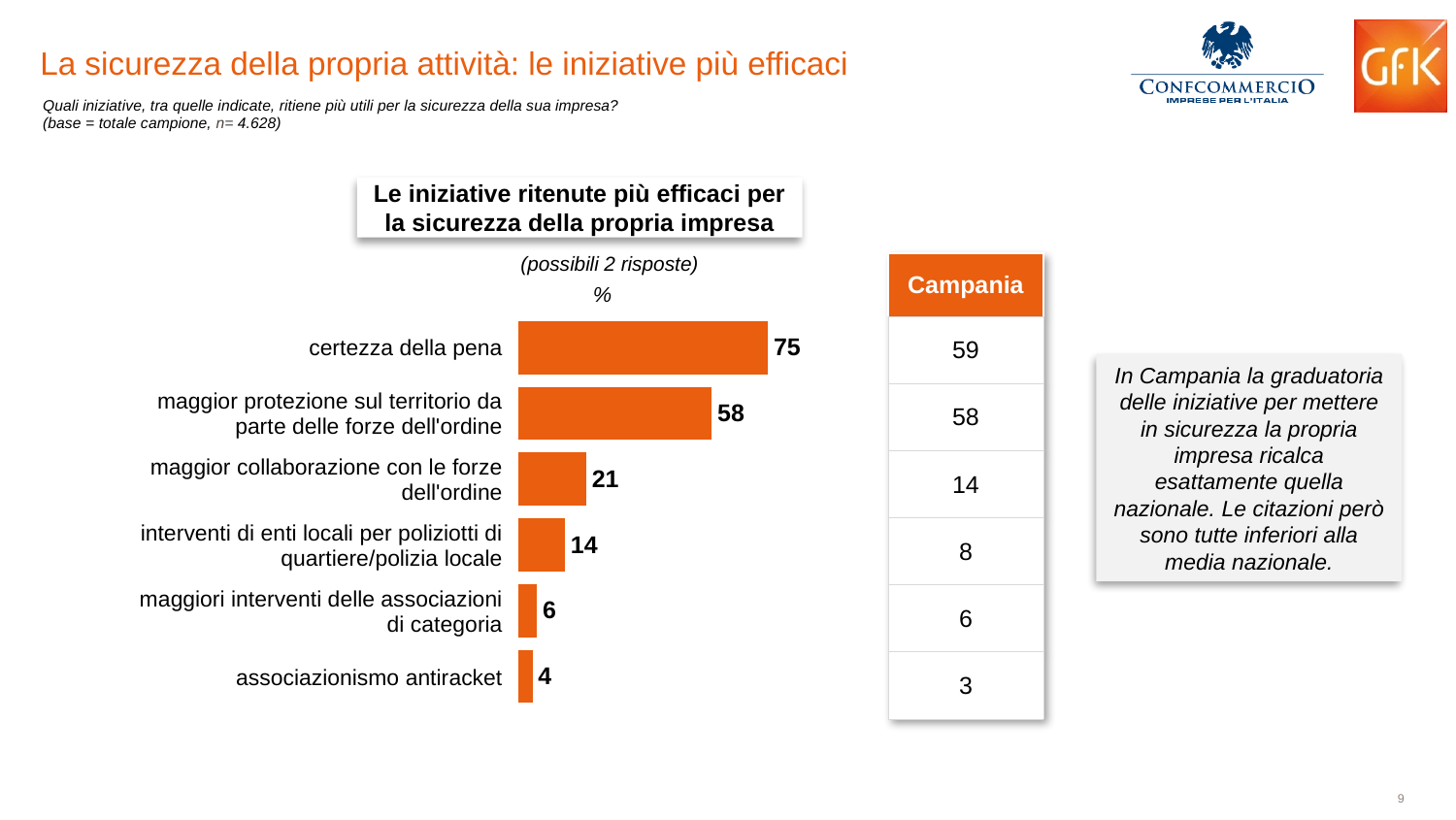
Which category has the lowest value in the bar chart? associazionismo antiracket What is the title shown above the bar chart? Le iniziative ritenute più efficaci per la sicurezza della propria impresa Which is larger in the bar chart: "maggior collaborazione con le forze dell'ordine" or "maggiori interventi delle associazioni di categoria"? maggior collaborazione con le forze dell'ordine How many categories are shown in the bar chart? 6 What is the difference between the values for "maggior collaborazione con le forze dell'ordine" and "interventi di enti locali per poliziotti di quartiere/polizia locale"? 7 What is the value for "associazionismo antiracket" in the bar chart? 4 What is the value for "interventi di enti locali per poliziotti di quartiere/polizia locale" in the bar chart? 14 Which category has the highest value in the bar chart? certezza della pena What is the difference between the values for "certezza della pena" and "maggior protezione sul territorio da parte delle forze dell'ordine"? 17 What is the value for "maggior protezione sul territorio da parte delle forze dell'ordine" in the bar chart? 58 What is the value for "certezza della pena" in the bar chart? 75 What kind of chart is shown on the slide? bar chart